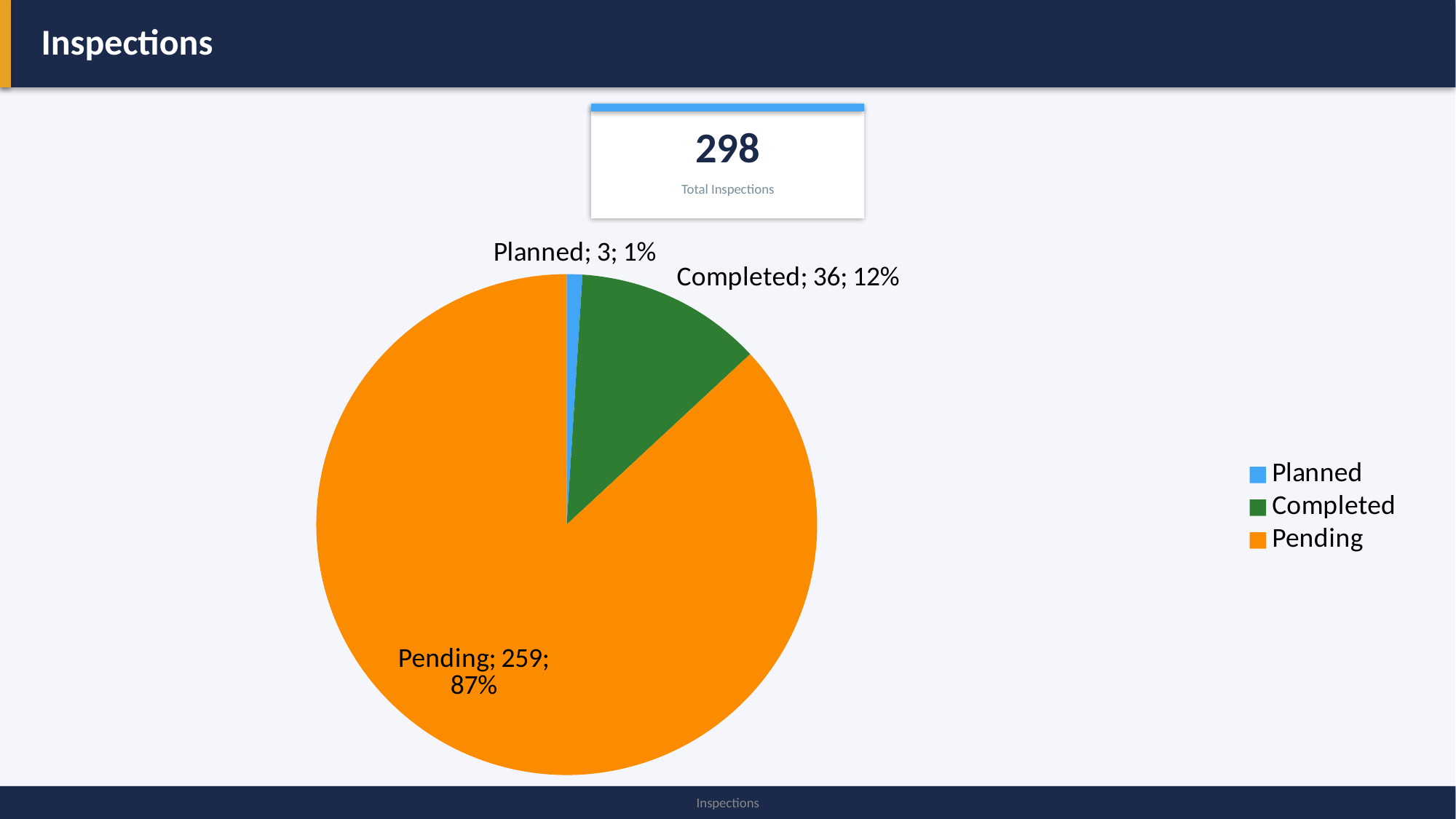
What type of chart is shown on the slide? pie chart Which is larger, the Completed count or the Planned count? Completed Which category has the smallest slice of the pie? Planned How many inspections are Pending? 259 How many categories does the pie chart have? 3 What share of the pie does the Completed slice represent? 12% What is the difference between the Pending and Completed counts? 223 How many inspections are Planned? 3 What share of the pie does the Pending slice represent? 87% How many inspections are Completed? 36 What is the total number of inspections shown in the box above the chart? 298 Which category has the largest slice of the pie? Pending